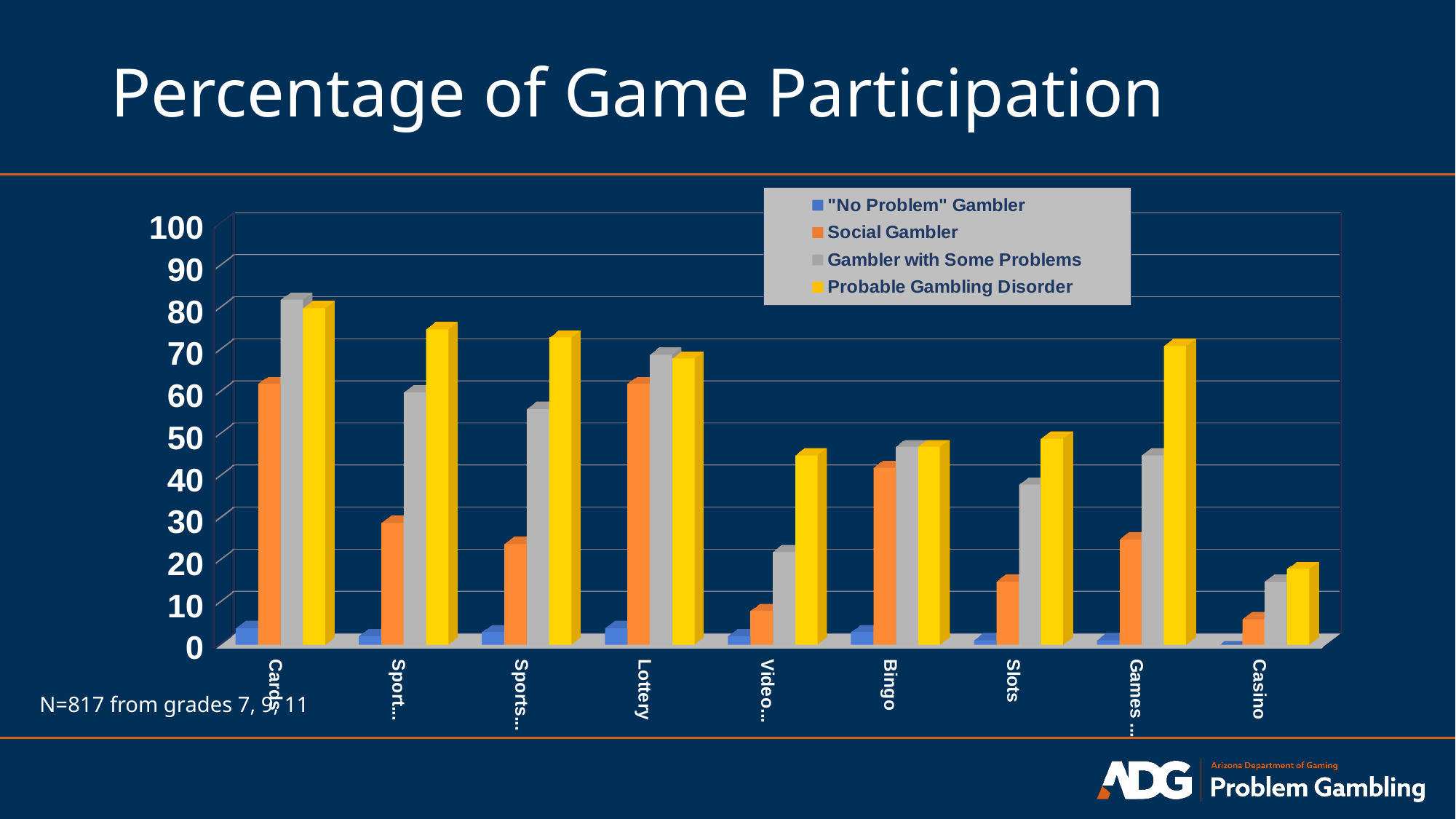
Which is larger: the Social Gambler value for Cards or the Social Gambler value for Slots? Cards Is the Gambler with Some Problems value for Video... greater or less than 30? less Which category has the lowest Probable Gambling Disorder value? Casino How many series does the legend list? 4 Which category has the highest Gambler with Some Problems value? Cards Is the Social Gambler value for Casino greater or less than 10? less How many game categories are shown along the x axis? 9 Is the Social Gambler value for Lottery greater or less than 50? greater What kind of chart is shown on the slide? bar chart What is the title of the slide? Percentage of Game Participation